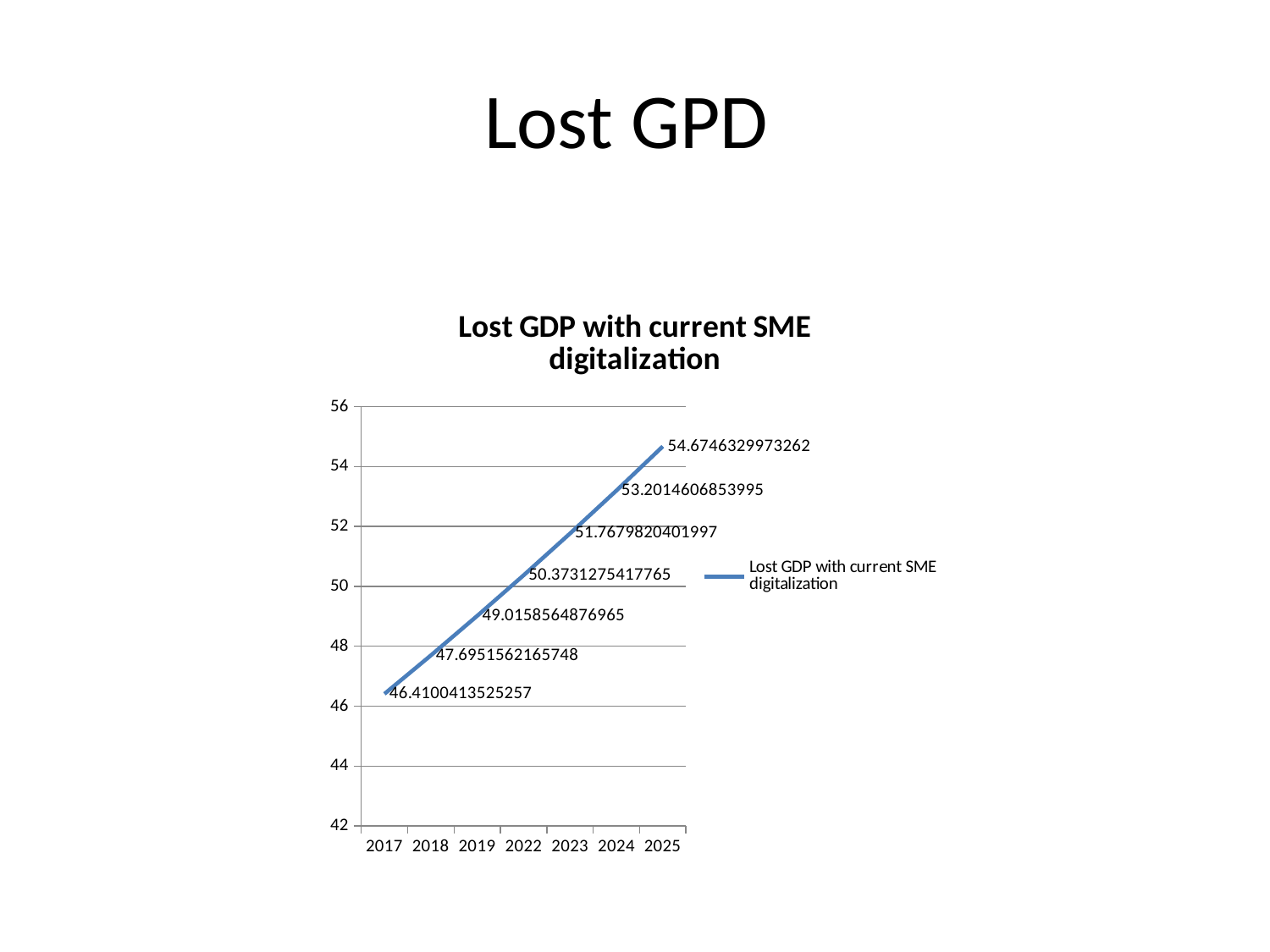
Which year has the lowest value? 2017 Do the values rise or fall from 2017 to 2025? rise What type of chart is shown on the slide? line chart What is the value for 2017? 46.4100413525257 How many data points are plotted on the line? 7 Which year has the highest value? 2025 What is the title of the chart? Lost GDP with current SME digitalization Which is larger, the value for 2019 or the value for 2023? 2023 What is the value for 2025? 54.6746329973262 Is the value for 2024 greater or less than 52? greater What is the value for 2022? 50.3731275417765 How many series does the legend list? 1